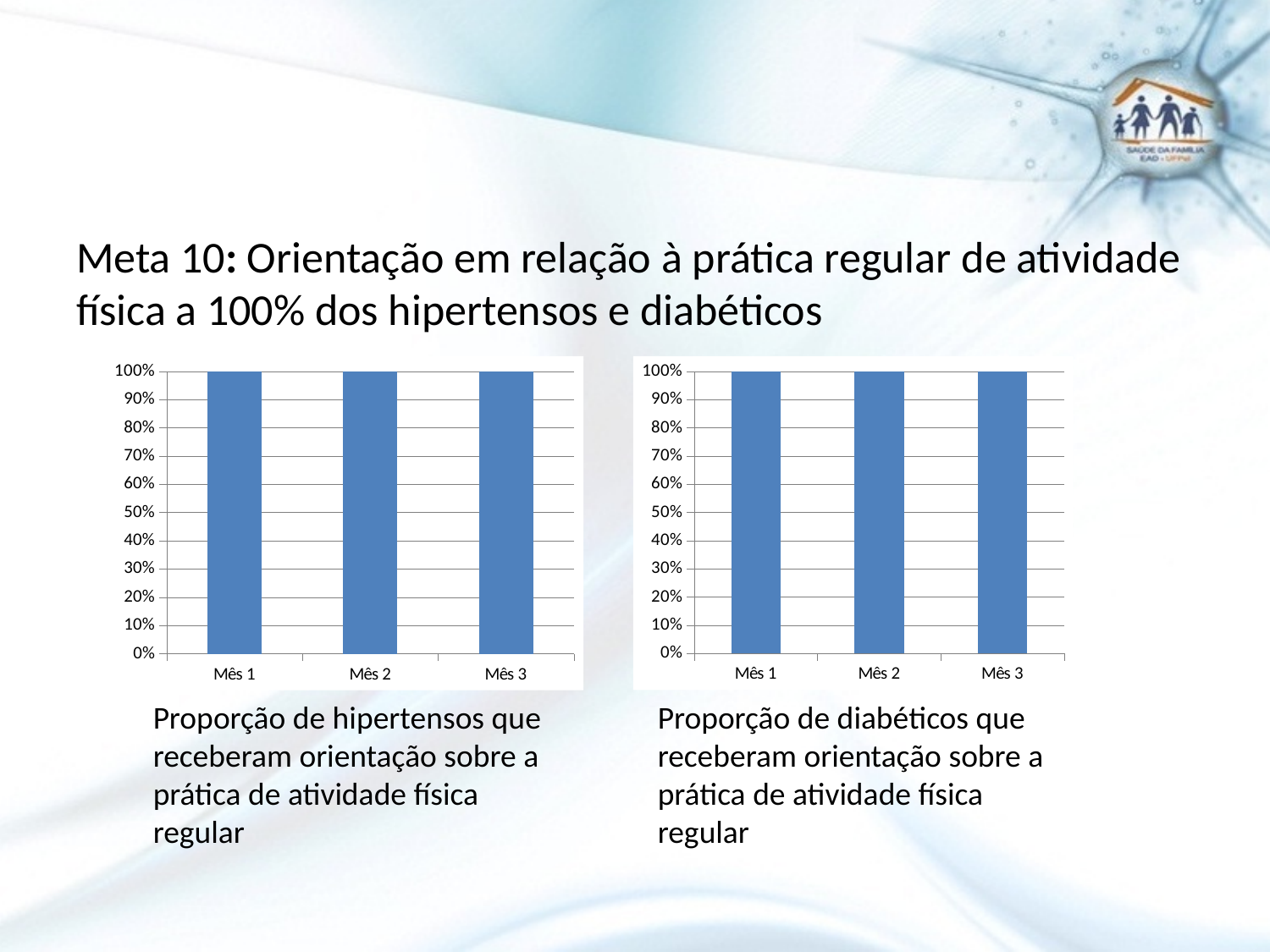
What kind of chart is the left chart (Proporção de hipertensos)? Bar chart What kind of chart is the right chart (Proporção de diabéticos)? Bar chart In the left chart (Proporção de hipertensos), what is the value for Mês 1? 100% In the right chart (Proporção de diabéticos), what is the value for Mês 2? 100% In the left chart (Proporção de hipertensos), do the values rise, fall or stay the same from Mês 1 to Mês 3? Stay the same In the right chart (Proporção de diabéticos), is the value for Mês 1 greater or less than 50%? greater In the left chart (Proporção de hipertensos), what is the difference between the values for Mês 1 and Mês 3? 0% How many bars are plotted in the right chart (Proporção de diabéticos)? 3 How many categories are shown on the x axis of the left chart (Proporção de hipertensos)? 3 In the right chart (Proporção de diabéticos), what is the value for Mês 3? 100% What is the label of the first category on the x axis of the right chart (Proporção de diabéticos)? Mês 1 In the left chart (Proporção de hipertensos), what is the value for Mês 2? 100%